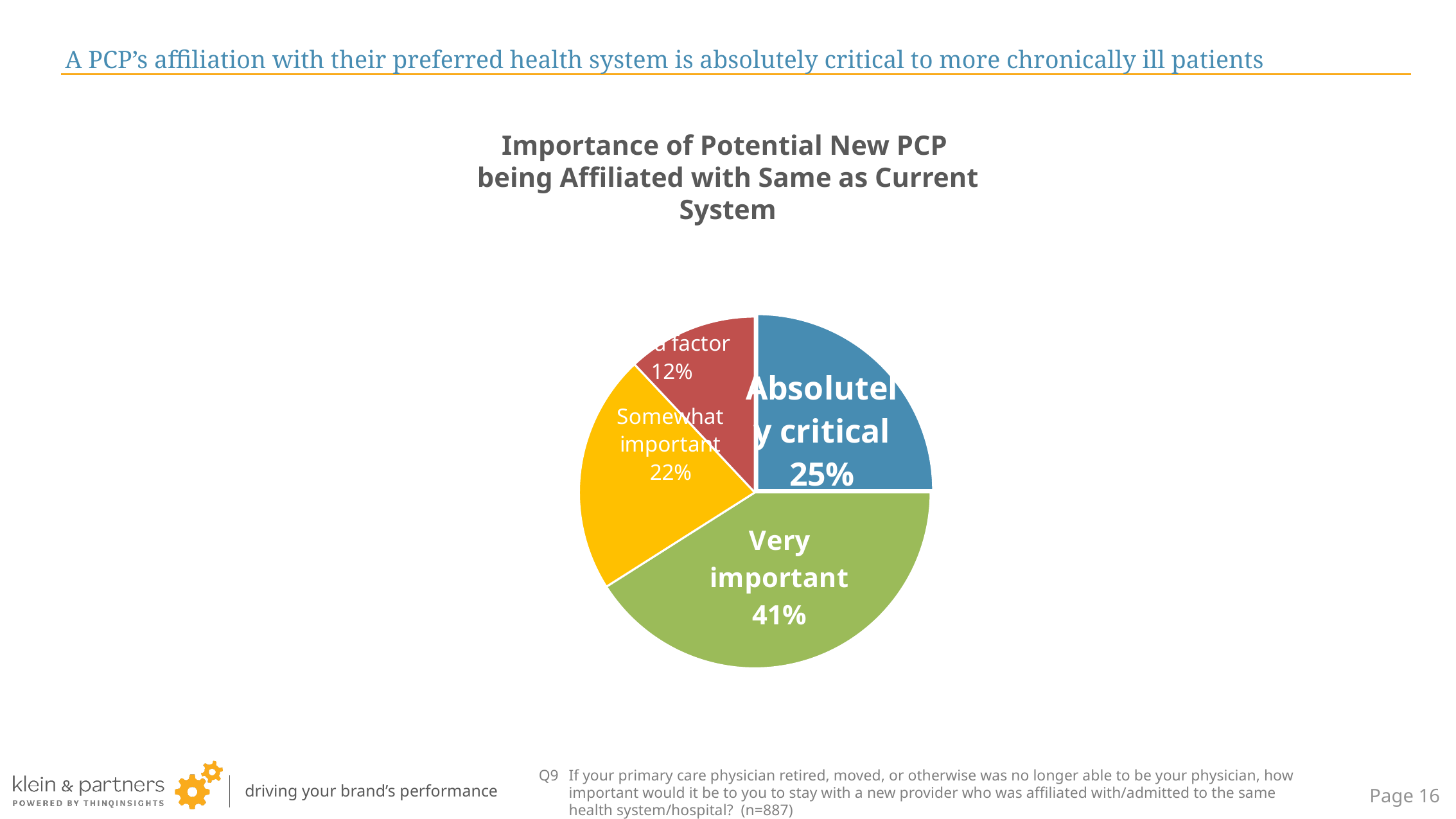
Which is larger: the share for "Absolutely critical" or the share for "Somewhat important"? Absolutely critical What is the difference in percentage points between "Very important" and "Absolutely critical"? 16 What is the title of the pie chart? Importance of Potential New PCP being Affiliated with Same as Current System What colour is the "Very important" slice? Green What percentage of respondents said it is "Very important" for a potential new PCP to be affiliated with the same system? 41% How many slices does the pie chart have? 4 What is the difference in percentage points between "Absolutely critical" and "Somewhat important"? 3 What is the combined percentage for "Absolutely critical" and "Very important"? 66% Which response category has the largest share of the pie? Very important What percentage of respondents said it is "Somewhat important"? 22% What percentage of respondents said it is "Absolutely critical"? 25% What type of chart is shown on the slide? Pie chart